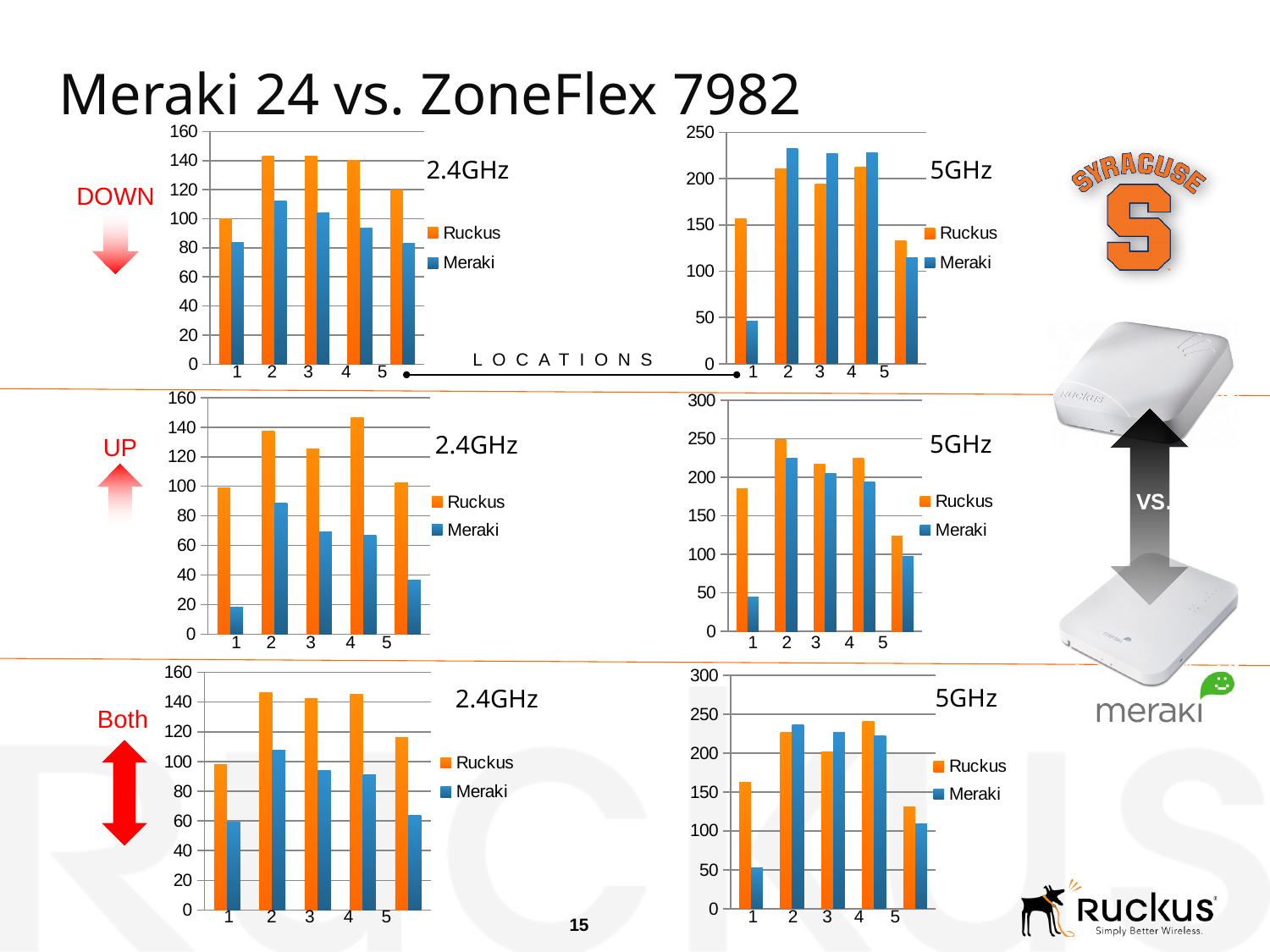
In the UP 2.4GHz chart, at which location is the Ruckus value highest? 4 In the Both 5GHz chart, at which location is the Ruckus value highest? 4 What kind of chart is the DOWN 2.4GHz chart at the top left? bar chart In the UP 5GHz chart, at which location is the Ruckus value lowest? 5 How many series does the legend of the DOWN 5GHz chart list? 2 In the Both 2.4GHz chart, is the Meraki value at location 2 greater or less than 100? greater In the DOWN 5GHz chart, which is larger at location 1, Ruckus or Meraki? Ruckus In the DOWN 2.4GHz chart, is the Ruckus value at location 2 greater or less than 120? greater What are the two legend entries in the Both 5GHz chart? Ruckus and Meraki In the DOWN 5GHz chart, at which location is the Meraki value lowest? 1 In the UP 2.4GHz chart, is the Meraki value at location 1 greater or less than 40? less How many locations are plotted on the x axis of the UP 2.4GHz chart? 5